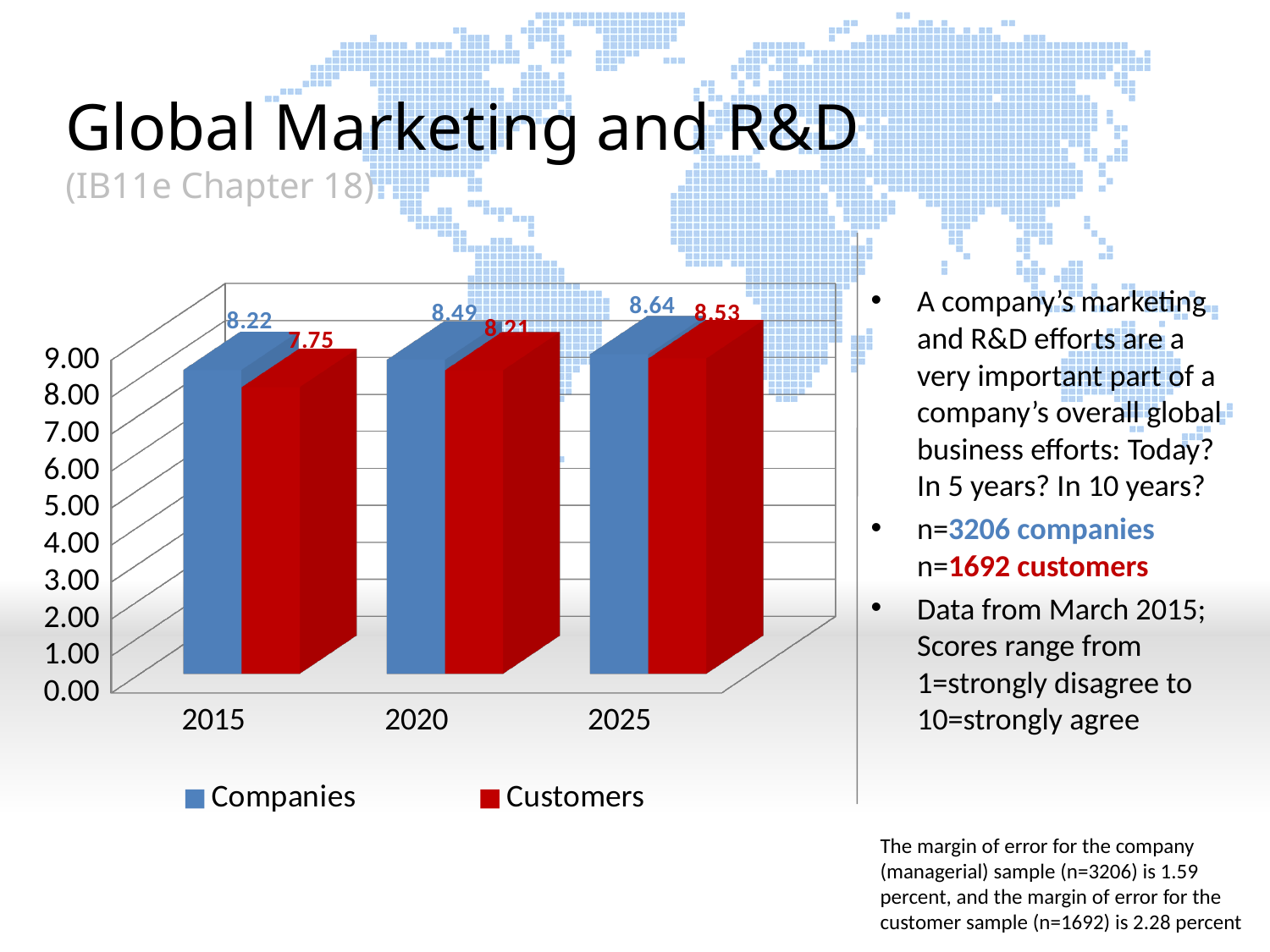
What is the difference between the Companies and Customers values in 2015? 0.47 Do the Customers values rise or fall from 2015 to 2025? Rise What is the value for Customers in 2025? 8.53 What is the value for Companies in 2015? 8.22 Which is larger in 2020, the Companies value or the Customers value? Companies In which year is the Customers value lowest? 2015 How many series does the legend list? 2 What is the value for Customers in 2015? 7.75 What kind of chart is shown on the slide? Bar chart How many years are shown on the x axis? 3 In which year is the Companies value highest? 2025 What is the value for Companies in 2025? 8.64